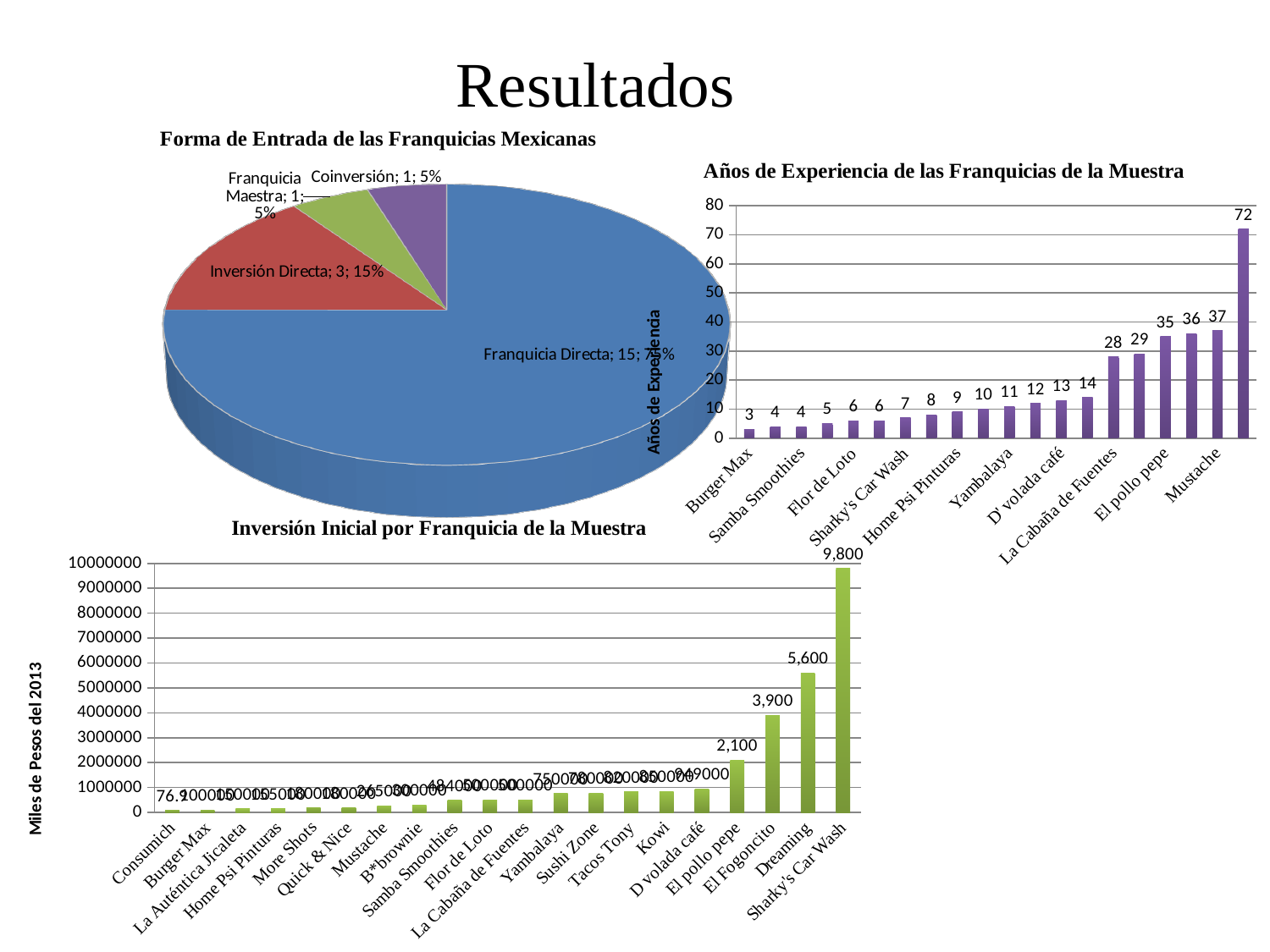
In the pie chart 'Forma de Entrada de las Franquicias Mexicanas', how many franchises are in the Inversión Directa slice? 3 What is the y-axis title of the chart 'Inversión Inicial por Franquicia de la Muestra'? Miles de Pesos del 2013 In the chart 'Inversión Inicial por Franquicia de la Muestra', which is larger, El pollo pepe or El Fogoncito? El Fogoncito How many bars are plotted in the chart 'Años de Experiencia de las Franquicias de la Muestra'? 20 In the pie chart 'Forma de Entrada de las Franquicias Mexicanas', which slice is the largest? Franquicia Directa In the chart 'Inversión Inicial por Franquicia de la Muestra', what is the value for Sharky's Car Wash? 9,800 In the pie chart 'Forma de Entrada de las Franquicias Mexicanas', what share does Inversión Directa have? 15% In the chart 'Años de Experiencia de las Franquicias de la Muestra', what is the highest value shown? 72 How many slices does the pie chart 'Forma de Entrada de las Franquicias Mexicanas' have? 4 In the chart 'Años de Experiencia de las Franquicias de la Muestra', what is the lowest value shown? 3 What kind of chart is 'Forma de Entrada de las Franquicias Mexicanas'? pie chart In the chart 'Inversión Inicial por Franquicia de la Muestra', what is the difference between the values for Dreaming and El Fogoncito? 1,700